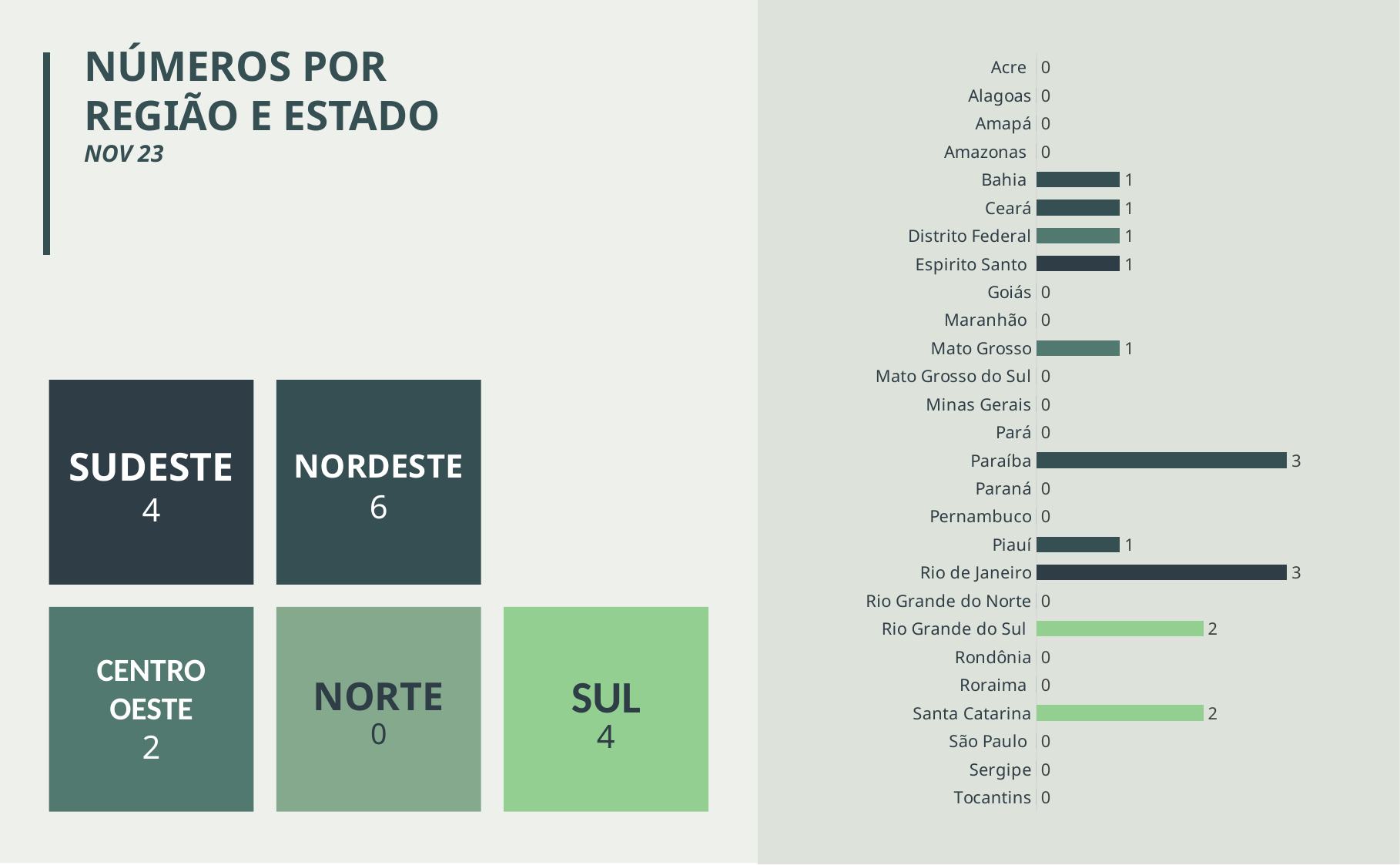
What is the value for Bahia in the bar chart? 1 What is the highest value shown in the bar chart? 3 What is the value for Rio Grande do Sul in the bar chart? 2 What is the value for Rio de Janeiro in the bar chart? 3 What is the difference between the values for Paraíba and Santa Catarina? 1 What is the difference between the values for Rio de Janeiro and Piauí? 2 Which has a larger value, Santa Catarina or Ceará? Santa Catarina What is the value for Paraíba in the bar chart? 3 How many states are listed in the bar chart? 27 What kind of chart is shown on the right side of the slide? Bar chart What is the value for Minas Gerais in the bar chart? 0 Which has a larger value, Rio de Janeiro or Mato Grosso? Rio de Janeiro